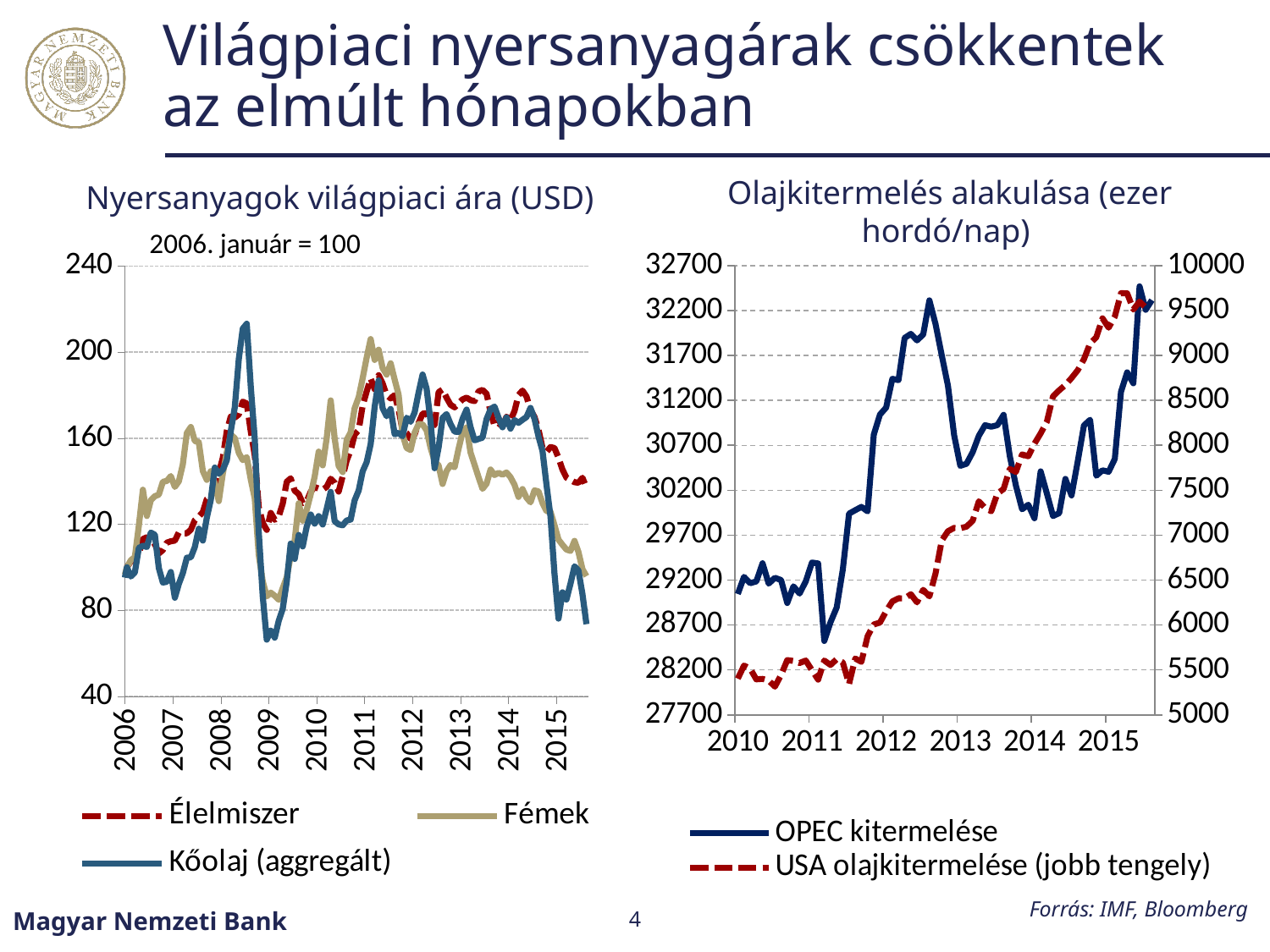
In the left chart 'Nyersanyagok világpiaci ára (USD)', how many series does the legend list? 3 In the right chart 'Olajkitermelés alakulása (ezer hordó/nap)', does USA olajkitermelése rise or fall overall from 2010 to 2015? rise In the left chart 'Nyersanyagok világpiaci ára (USD)', at the end of 2015, which is larger: Élelmiszer or Kőolaj (aggregált)? Élelmiszer In the left chart 'Nyersanyagok világpiaci ára (USD)', what base period is the index set to 100? 2006. január What kind of chart is the left chart titled 'Nyersanyagok világpiaci ára (USD)'? line chart In the left chart 'Nyersanyagok világpiaci ára (USD)', is the peak value of Kőolaj (aggregált) in 2008 greater or less than 200? greater In the right chart 'Olajkitermelés alakulása (ezer hordó/nap)', which series is plotted on the right axis according to the legend? USA olajkitermelése In the left chart 'Nyersanyagok világpiaci ára (USD)', is the lowest value of Kőolaj (aggregált) around the start of 2009 greater or less than 80? less What kind of chart is the right chart titled 'Olajkitermelés alakulása (ezer hordó/nap)'? line chart In the right chart 'Olajkitermelés alakulása (ezer hordó/nap)', how many series does the legend list? 2 In the right chart 'Olajkitermelés alakulása (ezer hordó/nap)', is the peak value of OPEC kitermelése in 2012 greater or less than 32200? greater